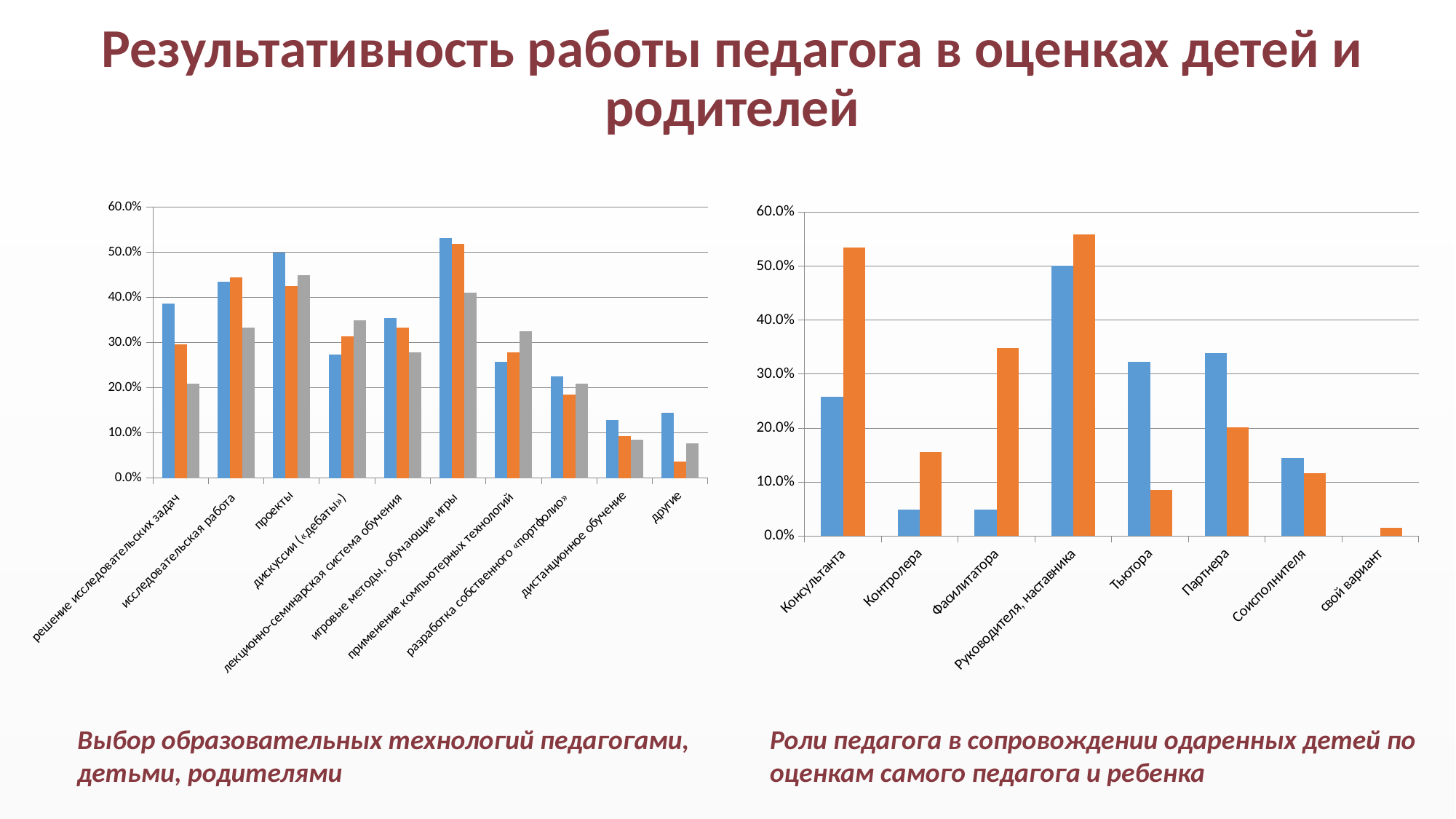
In the left chart (Выбор образовательных технологий), which category has the tallest blue bar? игровые методы, обучающие игры How many categories are shown on the x axis of the left chart (Выбор образовательных технологий)? 10 In the right chart (Роли педагога), which category has the lowest orange bar? свой вариант How many categories are shown on the x axis of the right chart (Роли педагога)? 8 In the right chart (Роли педагога), is the blue bar for Контролера greater or less than 10%? less How many differently coloured bar series are plotted in the left chart (Выбор образовательных технологий)? 3 In the left chart (Выбор образовательных технологий), for проекты, which bar is taller, the blue or the orange? blue In the right chart (Роли педагога), is the orange bar for Консультанта greater or less than 50%? greater In the left chart (Выбор образовательных технологий), is the blue bar for дистанционное обучение greater or less than 20%? less In the right chart (Роли педагога), which category has the tallest orange bar? Руководителя, наставника What kind of chart is the left chart (Выбор образовательных технологий)? bar chart In the right chart (Роли педагога), for Тьютора, which bar is taller, the blue or the orange? blue